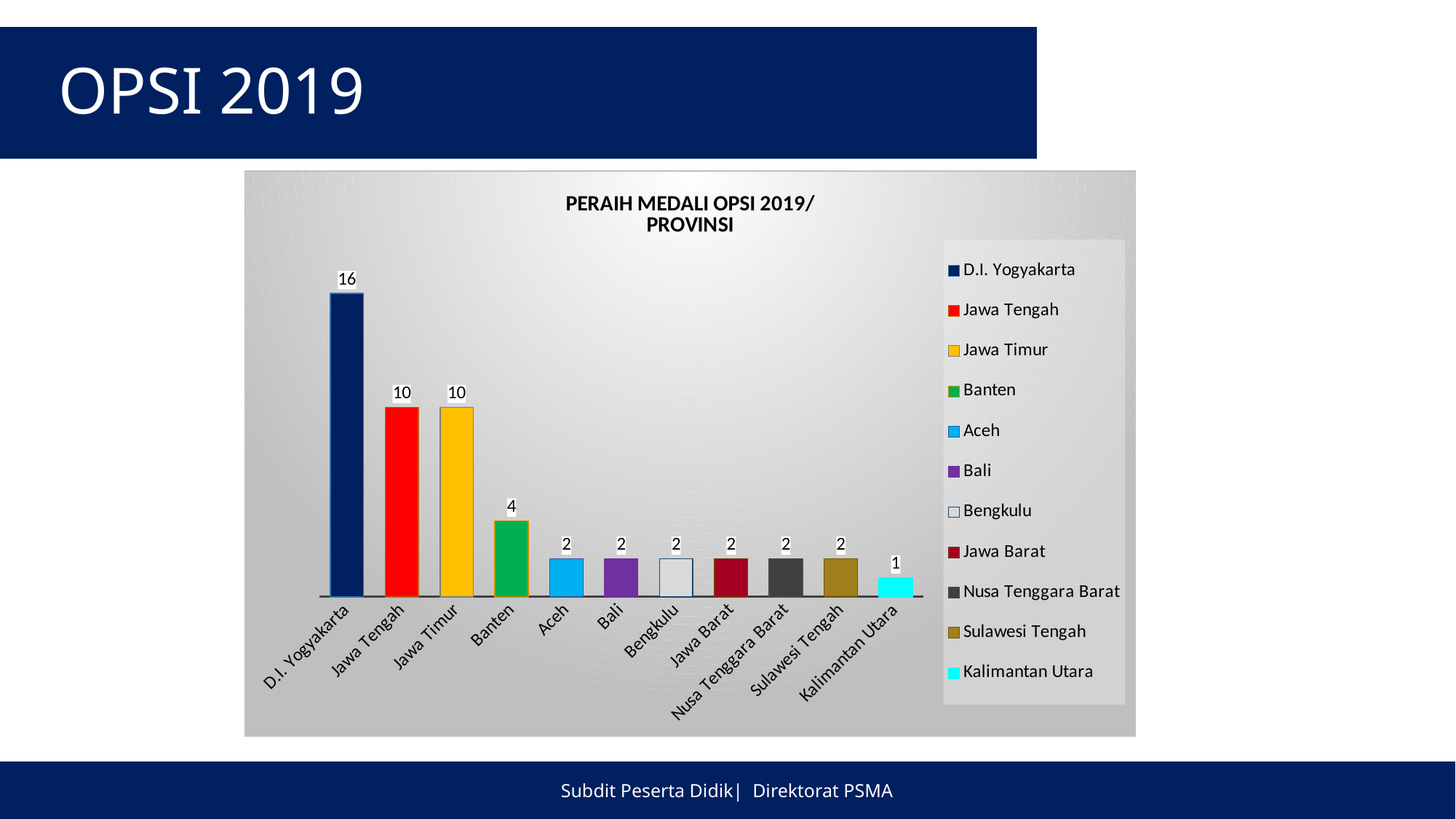
What kind of chart is shown on the slide? Bar chart What is the difference between the values for D.I. Yogyakarta and Jawa Tengah? 6 How many entries does the legend list? 11 What is the difference between the values for Banten and Aceh? 2 What is the value shown for Kalimantan Utara? 1 What is the value shown for Banten? 4 How many provinces are shown on the x axis of the chart? 11 How many medals did D.I. Yogyakarta win according to the chart? 16 Which is larger, the value for Jawa Timur or the value for Banten? Jawa Timur Which province has the lowest value in the chart? Kalimantan Utara What is the title of the chart? PERAIH MEDALI OPSI 2019/ PROVINSI Which province has the highest value in the chart? D.I. Yogyakarta